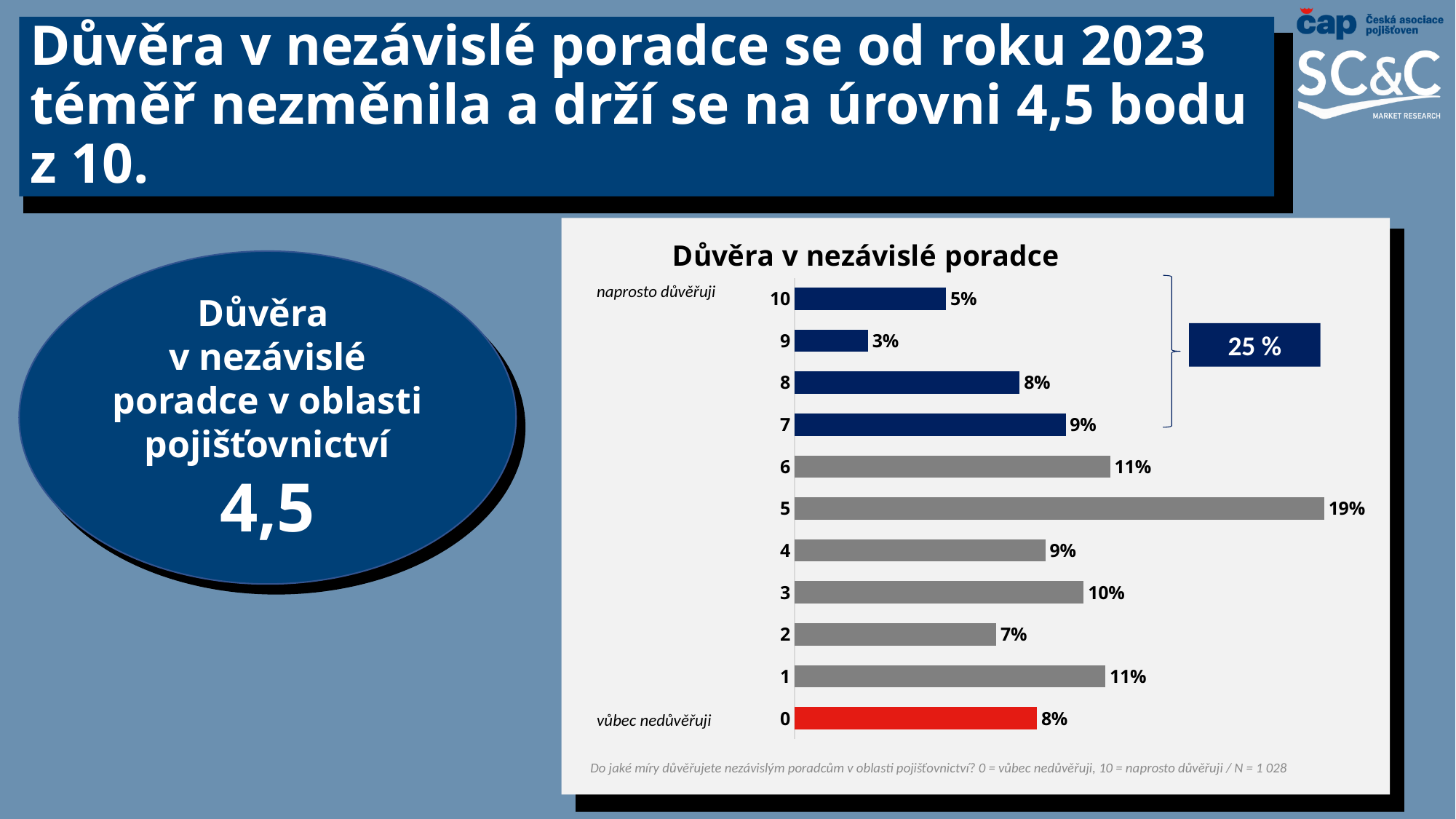
What percentage of respondents gave a rating of 5? 19% What is the difference between the percentage for rating 5 and the percentage for rating 9? 16% What is the total percentage for ratings 1 and 2 combined? 18% What type of chart is shown on the slide? bar chart Which has a larger percentage: rating 3 or rating 2? rating 3 How many rating categories are shown in the chart? 11 What percentage of respondents gave a rating of 10 (naprosto důvěřuji)? 5% What is the title of the chart? Důvěra v nezávislé poradce Which rating has the lowest percentage of respondents? 9 What percentage of respondents gave a rating of 0 (vůbec nedůvěřuji)? 8% Which rating has the highest percentage of respondents? 5 What combined percentage is shown for ratings 7 to 10 in the bracket label? 25 %